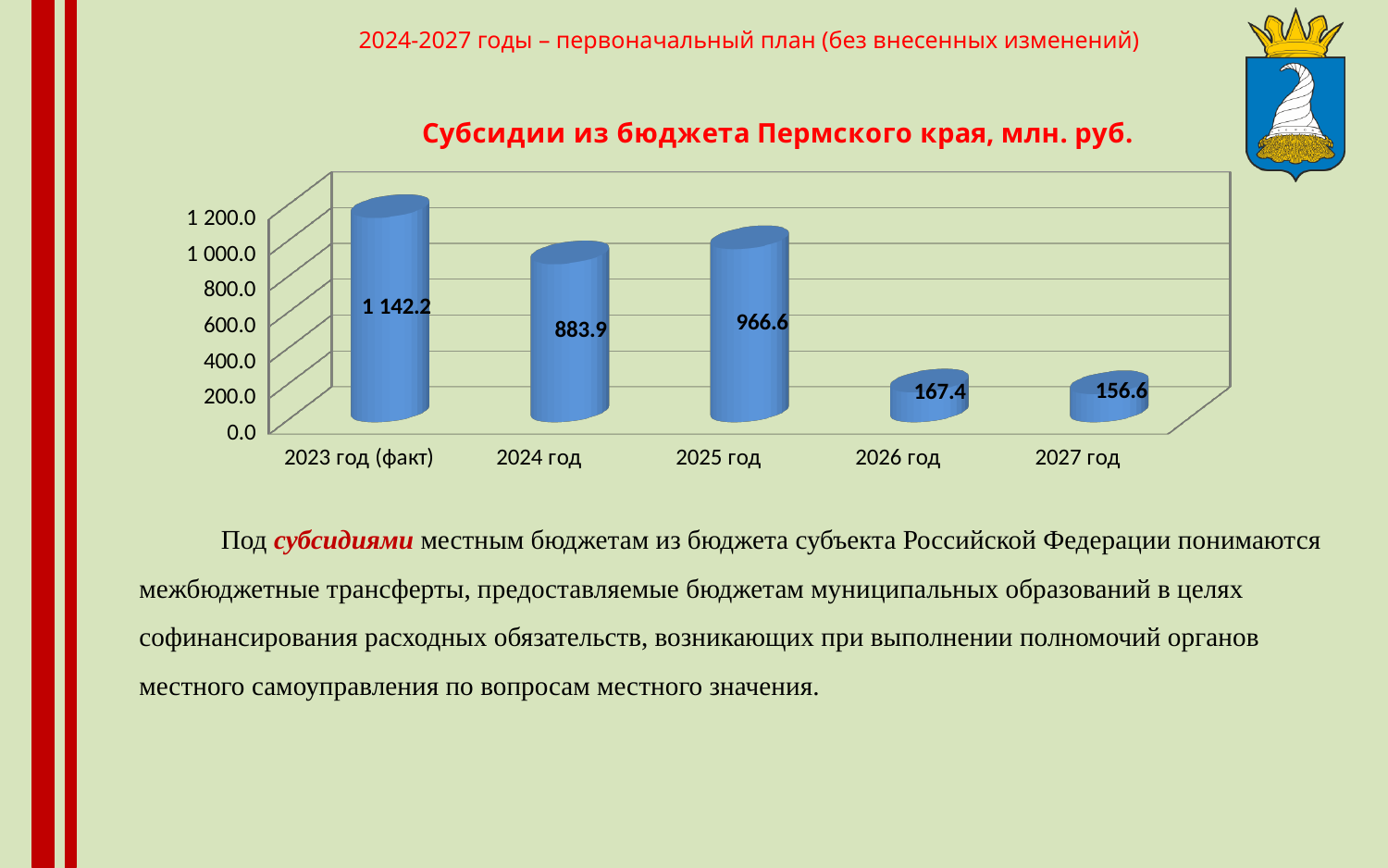
What is the value for 2023 год (факт)? 1 142.2 Is the value for 2026 год greater or less than 200.0? less Which is larger, the value for 2024 год or the value for 2025 год? 2025 год What is the title of the chart? Субсидии из бюджета Пермского края, млн. руб. What is the difference between the values for 2025 год and 2024 год? 82.7 What is the value for 2027 год? 156.6 Which category has the lowest value? 2027 год What kind of chart is shown on the slide? bar chart What is the difference between the values for 2023 год (факт) and 2024 год? 258.3 How many categories are shown on the x axis? 5 Which category has the highest value? 2023 год (факт) What is the value for 2025 год? 966.6